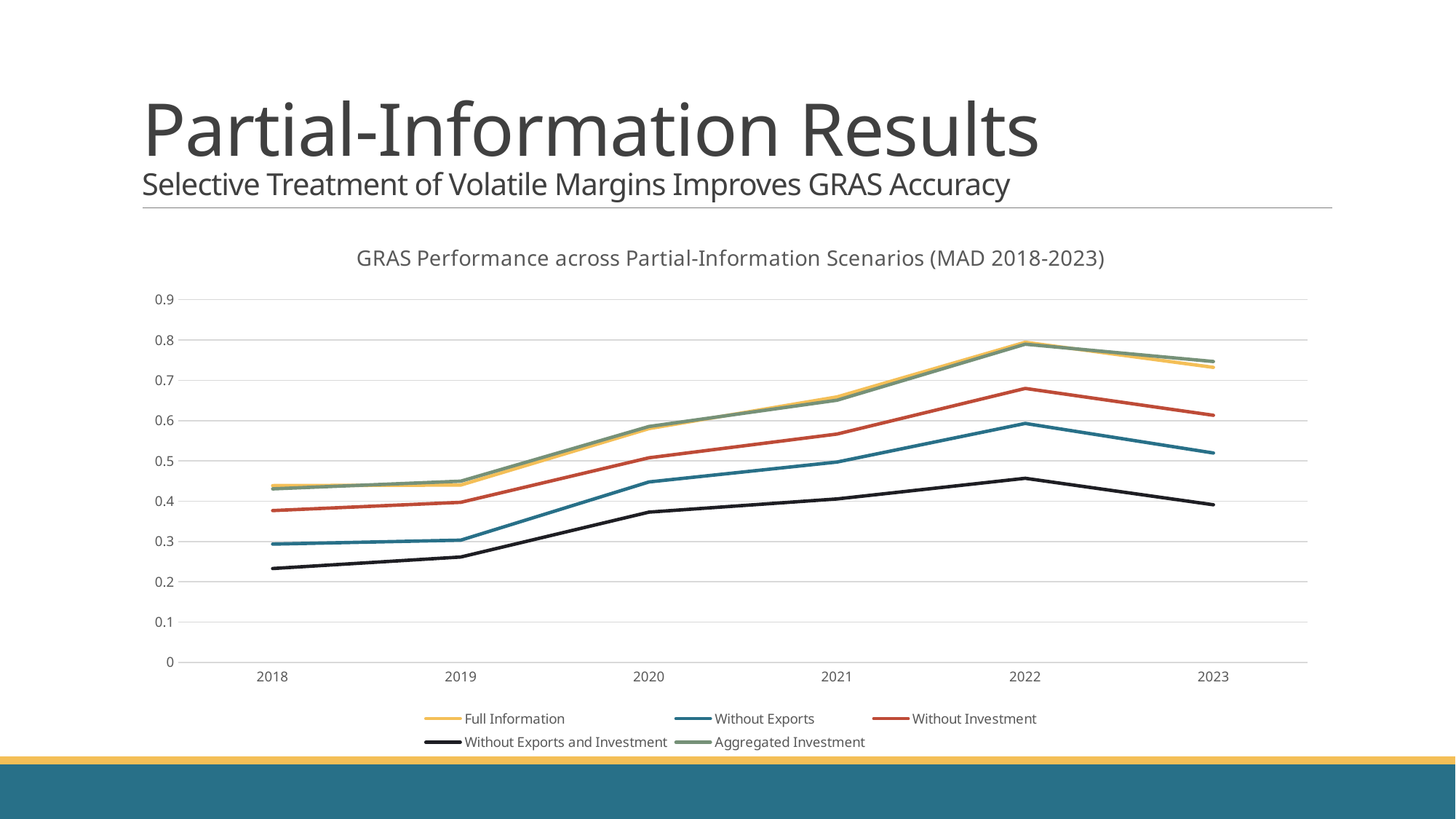
In which year is the Without Exports series at its lowest value? 2018 Which series has the lowest values across all years? Without Exports and Investment How many series does the legend list? 5 What colour is the line for Without Exports and Investment? Black Is the value for Without Investment in 2022 greater or less than 0.6? greater What kind of chart is shown on the slide? Line chart How many years are plotted along the x axis? 6 What is the title of the chart? GRAS Performance across Partial-Information Scenarios (MAD 2018-2023) In 2023, which is larger: Without Investment or Without Exports? Without Investment In which year does the Without Exports and Investment series reach its highest value? 2022 Is the value for Without Exports and Investment in 2018 greater or less than 0.3? less Does the Without Exports series rise or fall from 2018 to 2022? Rise